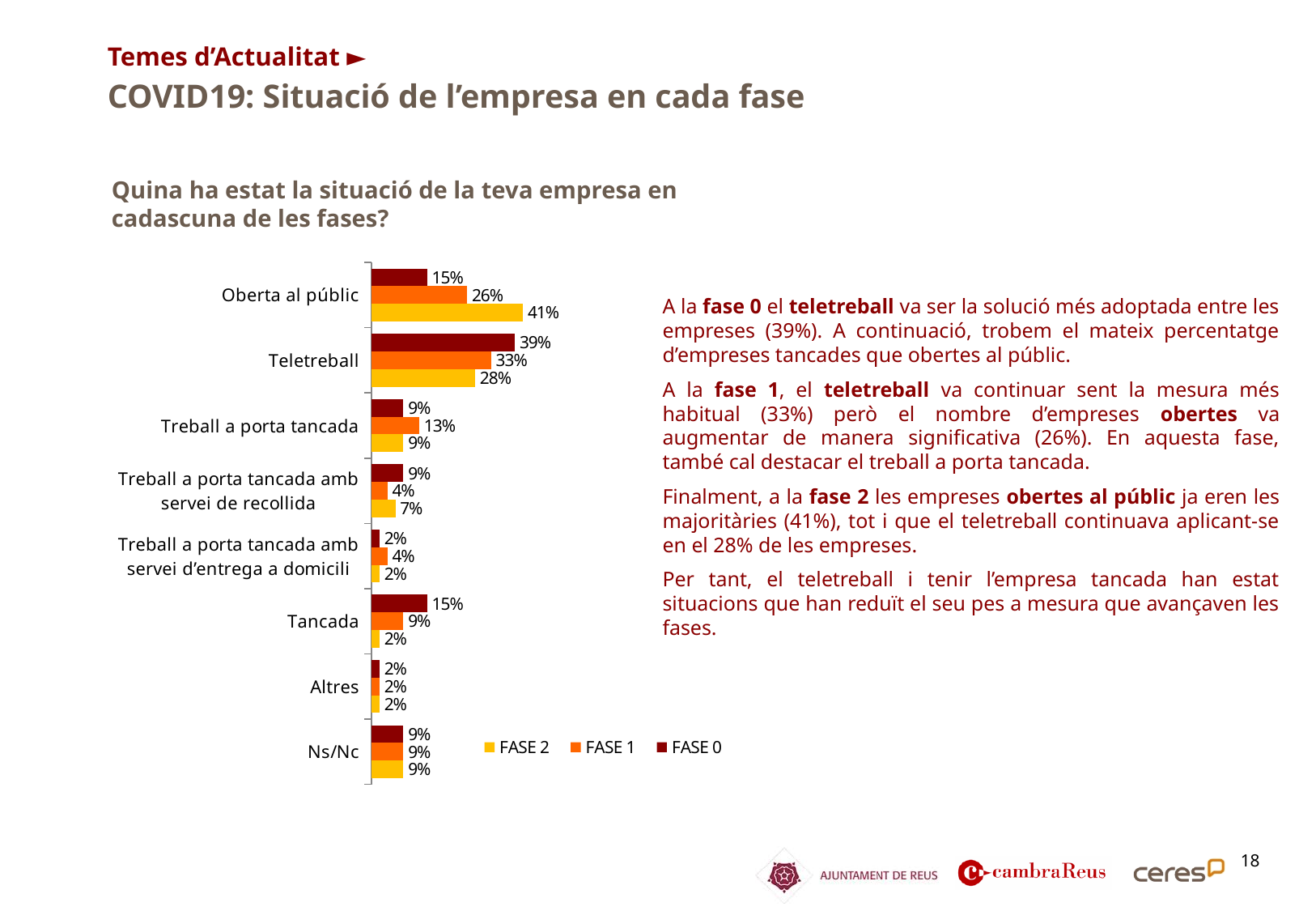
What is the FASE 0 value for Teletreball? 39% How many categories are shown on the chart? 8 What is the FASE 2 value for Oberta al públic? 41% How many series does the legend list? 3 Which category has the highest FASE 2 value? Oberta al públic What kind of chart is shown on the slide? Bar chart Which is larger for Teletreball: the FASE 1 value or the FASE 2 value? FASE 1 What is the FASE 0 value for Tancada? 15% Which category has the highest FASE 0 value? Teletreball Which colour represents FASE 0 in the legend? Dark red What is the difference between the FASE 2 and FASE 0 values for Oberta al públic? 26% What is the FASE 1 value for Treball a porta tancada? 13%